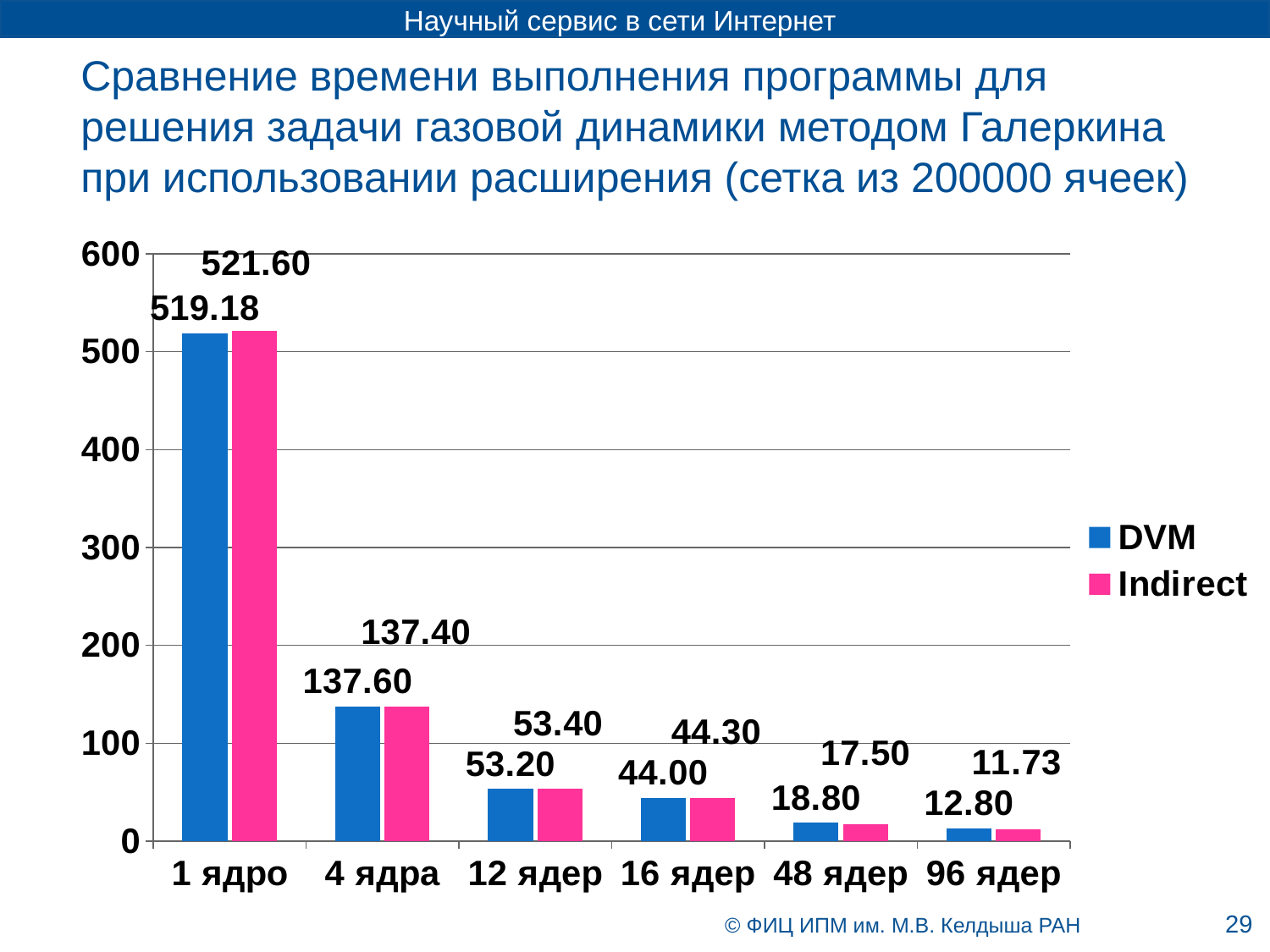
What kind of chart is shown on the slide? Bar chart How many series does the legend list? 2 Which category has the highest DVM value? 1 ядро What is the Indirect value for 4 ядра? 137.40 What is the DVM value for 1 ядро? 519.18 What is the Indirect value for 96 ядер? 11.73 For 16 ядер, which series has the larger value, DVM or Indirect? Indirect How many categories are shown on the x axis? 6 Which category has the lowest Indirect value? 96 ядер Do the DVM values rise or fall as the number of cores increases along the x axis? Fall What is the DVM value for 48 ядер? 18.80 What is the difference between the DVM and Indirect values for 48 ядер? 1.30